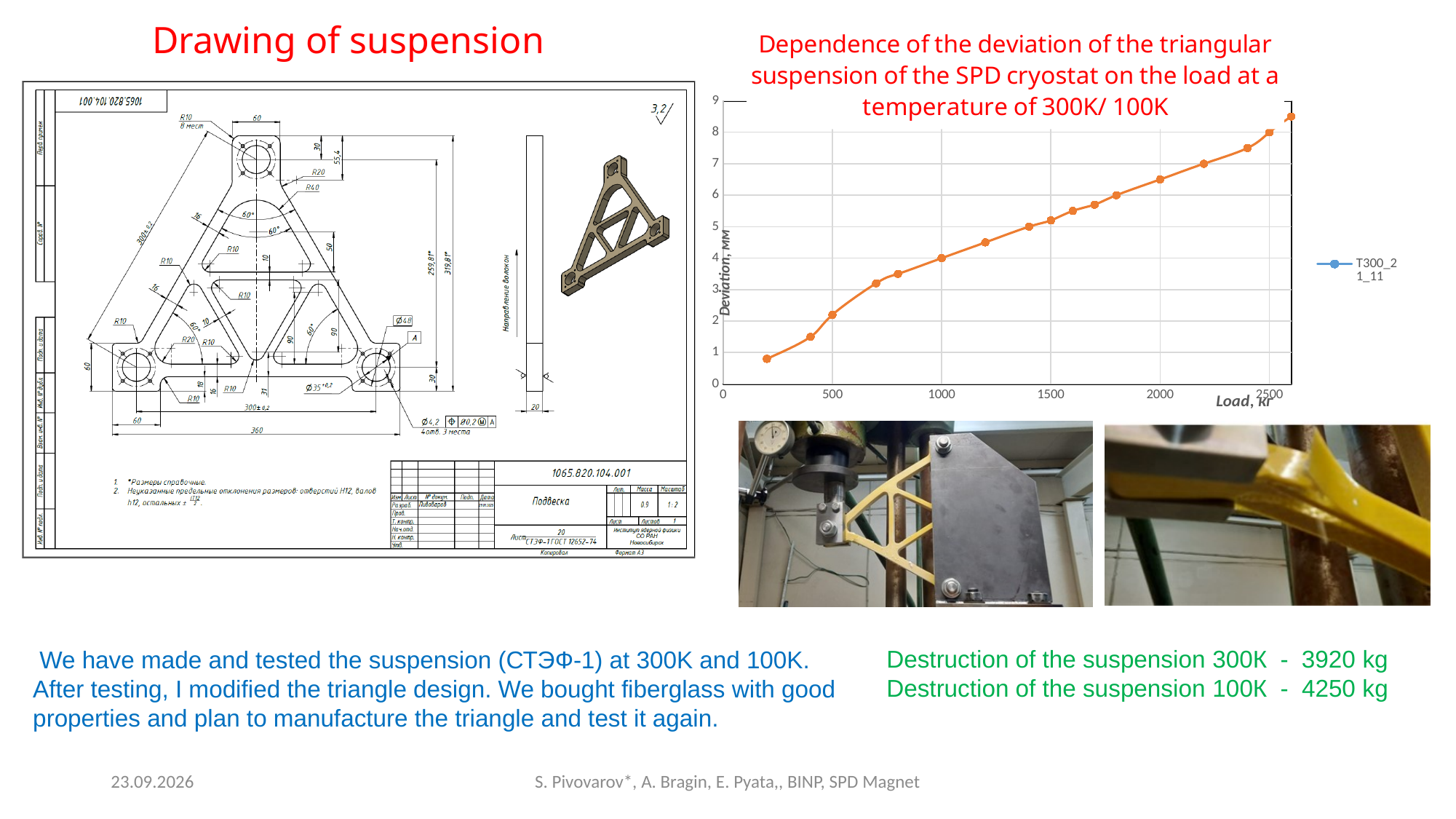
How many series does the chart legend list? 1 Is the highest deviation on the chart greater or less than 8 mm? greater Which has the larger deviation: a load of 500 kg or a load of 1500 kg? 1500 kg Does the deviation rise or fall as the load increases along the x axis? rises What is the name of the series shown in the chart legend? T300_21_11 At which end of the load range is the deviation lowest: the smallest load or the largest load? the smallest load What is the label of the vertical axis of the chart? Deviation, мм Is the deviation at a load of 1000 kg greater or less than 3 mm? greater Is the deviation at a load of 2000 kg greater or less than 6 mm? greater What kind of chart is shown on the slide? line chart